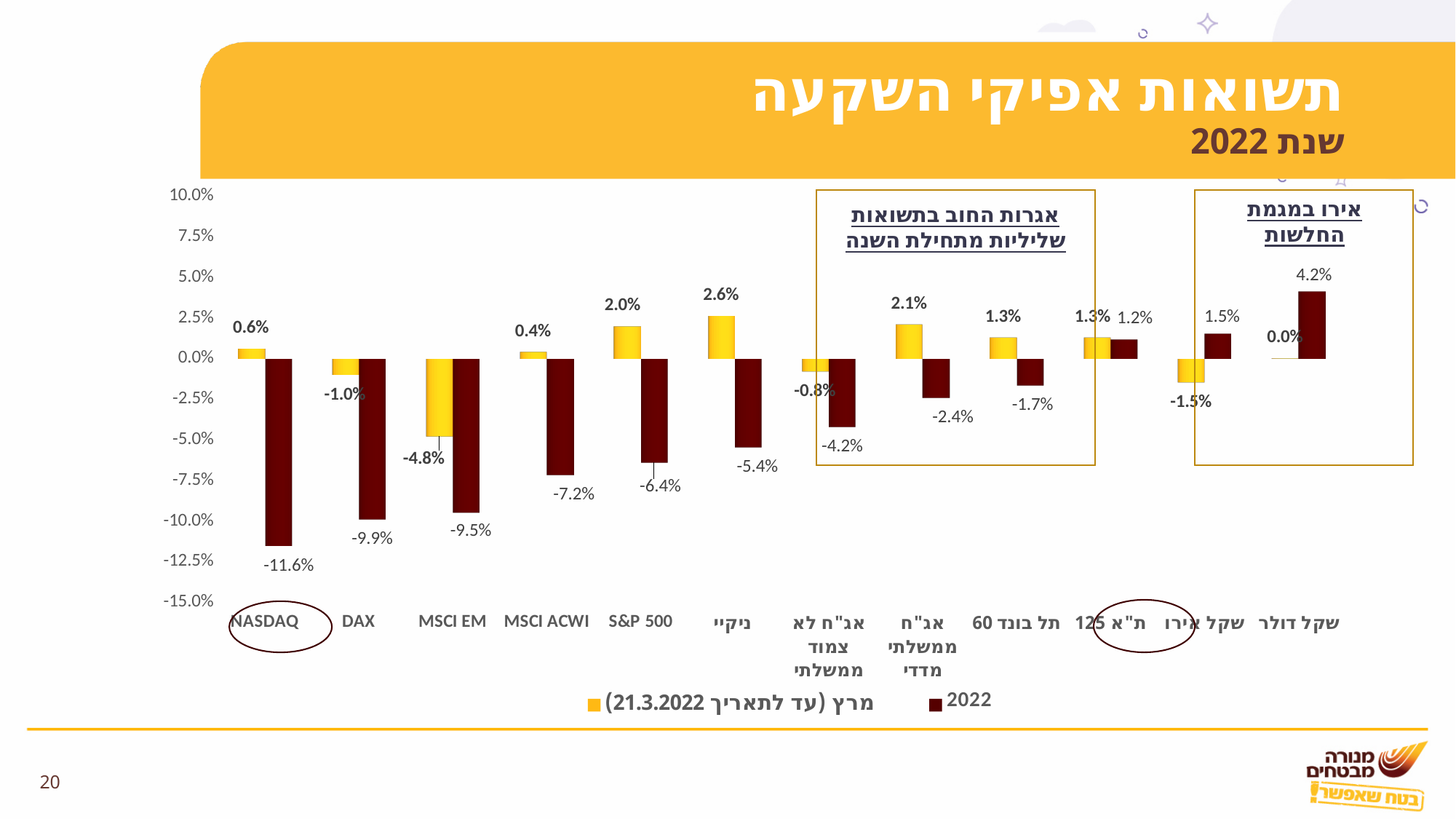
What is the March (עד לתאריך 21.3.2022) value for MSCI EM? -4.8% What is the 2022 value for שקל דולר? 4.2% What is the difference between the 2022 values for DAX and MSCI EM? 0.4% How many series does the legend list? 2 Which is larger: the 2022 value for S&P 500 or the 2022 value for ניקיי? ניקיי What is the 2022 value for NASDAQ? -11.6% Which category has the lowest 2022 value? NASDAQ Which colour represents the 2022 series? Dark red What kind of chart is shown on the slide? Bar chart How many categories are shown on the x axis? 12 Which category has the highest March (עד לתאריך 21.3.2022) value? ניקיי What is the March (עד לתאריך 21.3.2022) value for S&P 500? 2.0%